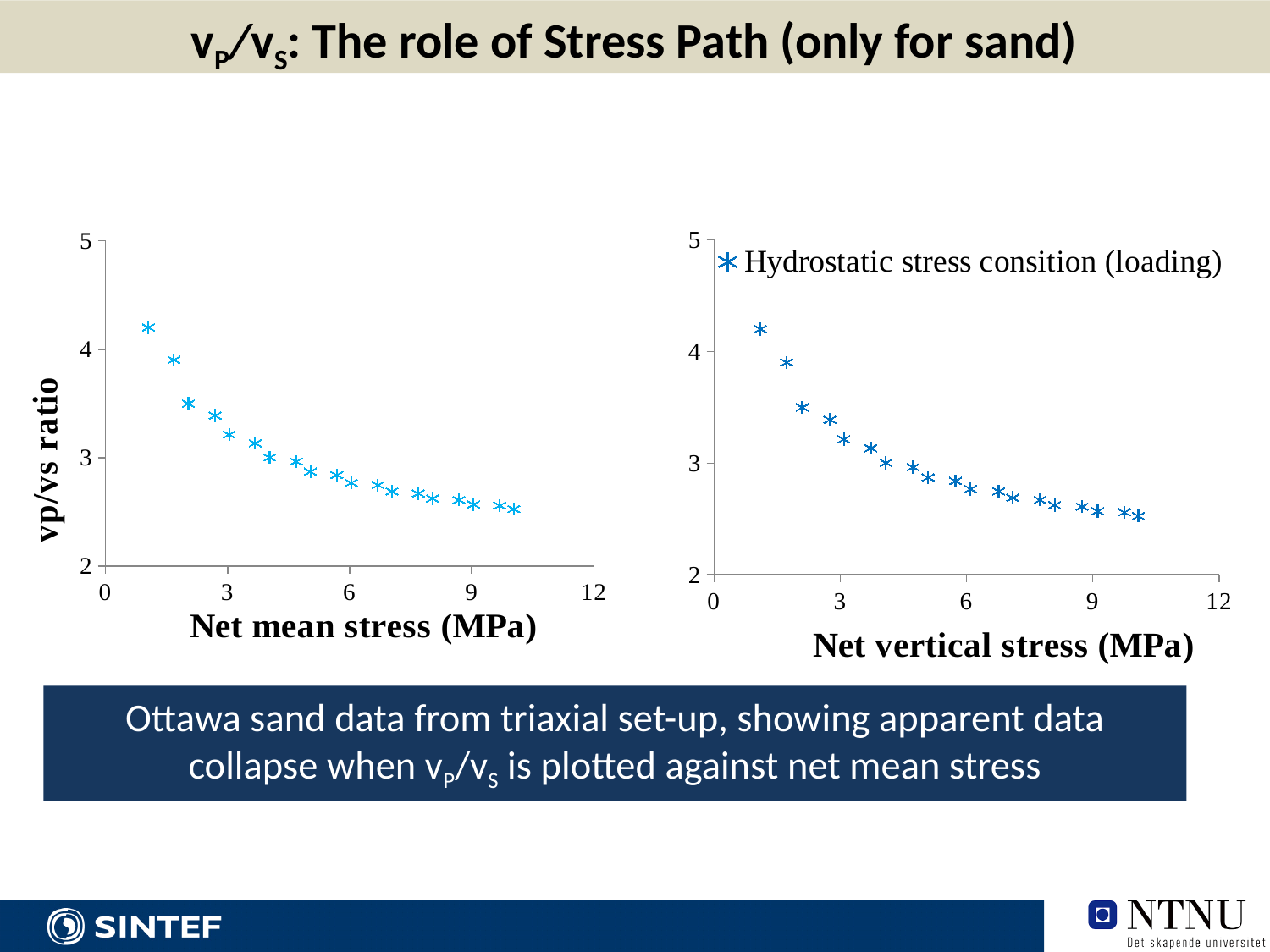
What is the x-axis label of the left chart? Net mean stress (MPa) How many series does the legend of the right chart (Net vertical stress) list? 1 In the right chart (Net vertical stress), do the vp/vs ratio values rise or fall as net vertical stress increases? fall What kind of chart is the left chart, titled with x axis 'Net mean stress (MPa)'? scatter chart In the left chart (Net mean stress), is the vp/vs ratio of the leftmost data point (at about 1 MPa) greater or less than 4? greater What is the series name shown in the legend of the right chart (Net vertical stress)? Hydrostatic stress consition (loading) In the left chart (Net mean stress), do the vp/vs ratio values rise or fall as net mean stress increases? fall In the right chart (Net vertical stress), is the vp/vs ratio of the data points near 9 MPa greater or less than 3? less In the right chart (Net vertical stress), is the vp/vs ratio of the leftmost data point (at about 1 MPa) greater or less than 4? greater What is the maximum value shown on the x axis of the right chart (Net vertical stress)? 12 In the left chart (Net mean stress), which has the higher vp/vs ratio: the data point at about 1 MPa or the data point at about 10 MPa? the data point at about 1 MPa